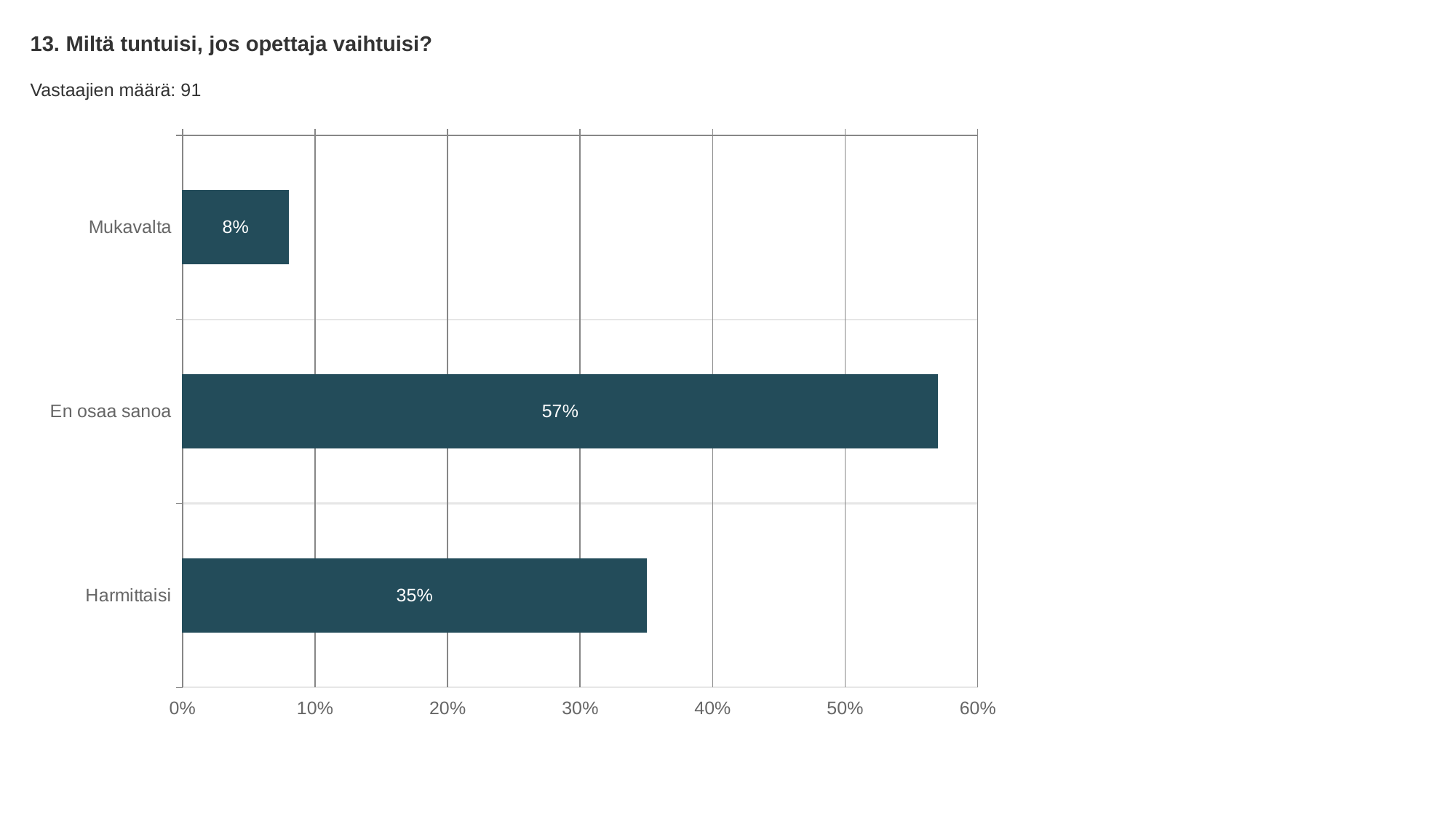
Which is larger, the value for Harmittaisi or the value for Mukavalta? Harmittaisi How many respondents (Vastaajien määrä) are reported on the slide? 91 What is the difference between the values for Harmittaisi and Mukavalta? 27% What is the value for Mukavalta? 8% Which category has the lowest value? Mukavalta What is the difference between the values for En osaa sanoa and Harmittaisi? 22% Which category has the highest value? En osaa sanoa What is the value for Harmittaisi? 35% What is the value for En osaa sanoa? 57% What kind of chart is shown on the slide? bar chart How many categories are shown in the chart? 3 Is the value for En osaa sanoa greater or less than 50%? greater